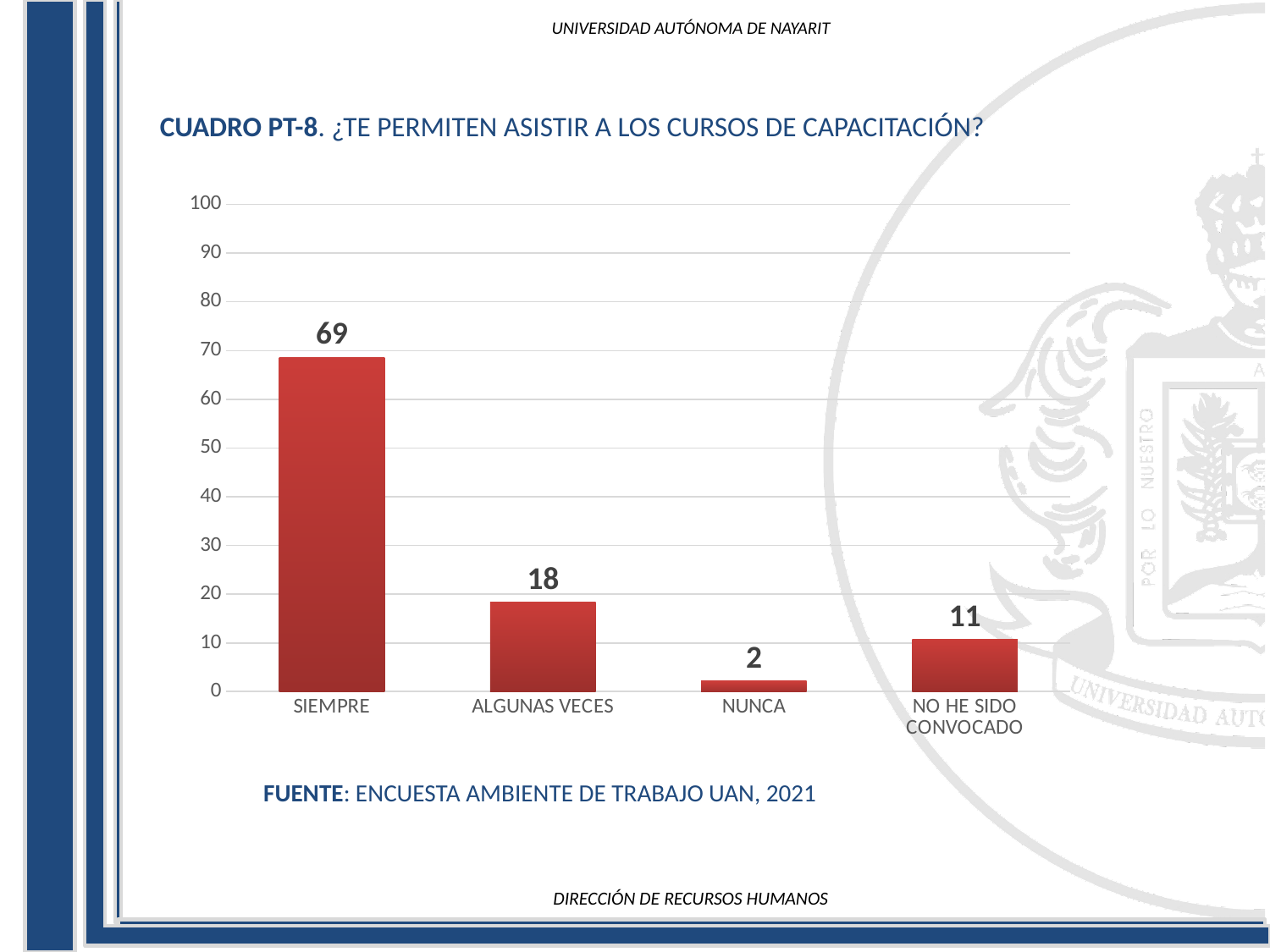
What is the source cited below the chart? ENCUESTA AMBIENTE DE TRABAJO UAN, 2021 Which category has the lowest value? NUNCA What is the value for NUNCA? 2 What is the value for SIEMPRE? 69 What kind of chart is shown on the slide? bar chart Which is larger, the value for ALGUNAS VECES or the value for NO HE SIDO CONVOCADO? ALGUNAS VECES What is the difference between the values for SIEMPRE and ALGUNAS VECES? 51 Which category has the highest value? SIEMPRE Is the value for SIEMPRE greater or less than 60? greater How many categories are shown on the x axis? 4 What is the value for NO HE SIDO CONVOCADO? 11 What is the value for ALGUNAS VECES? 18